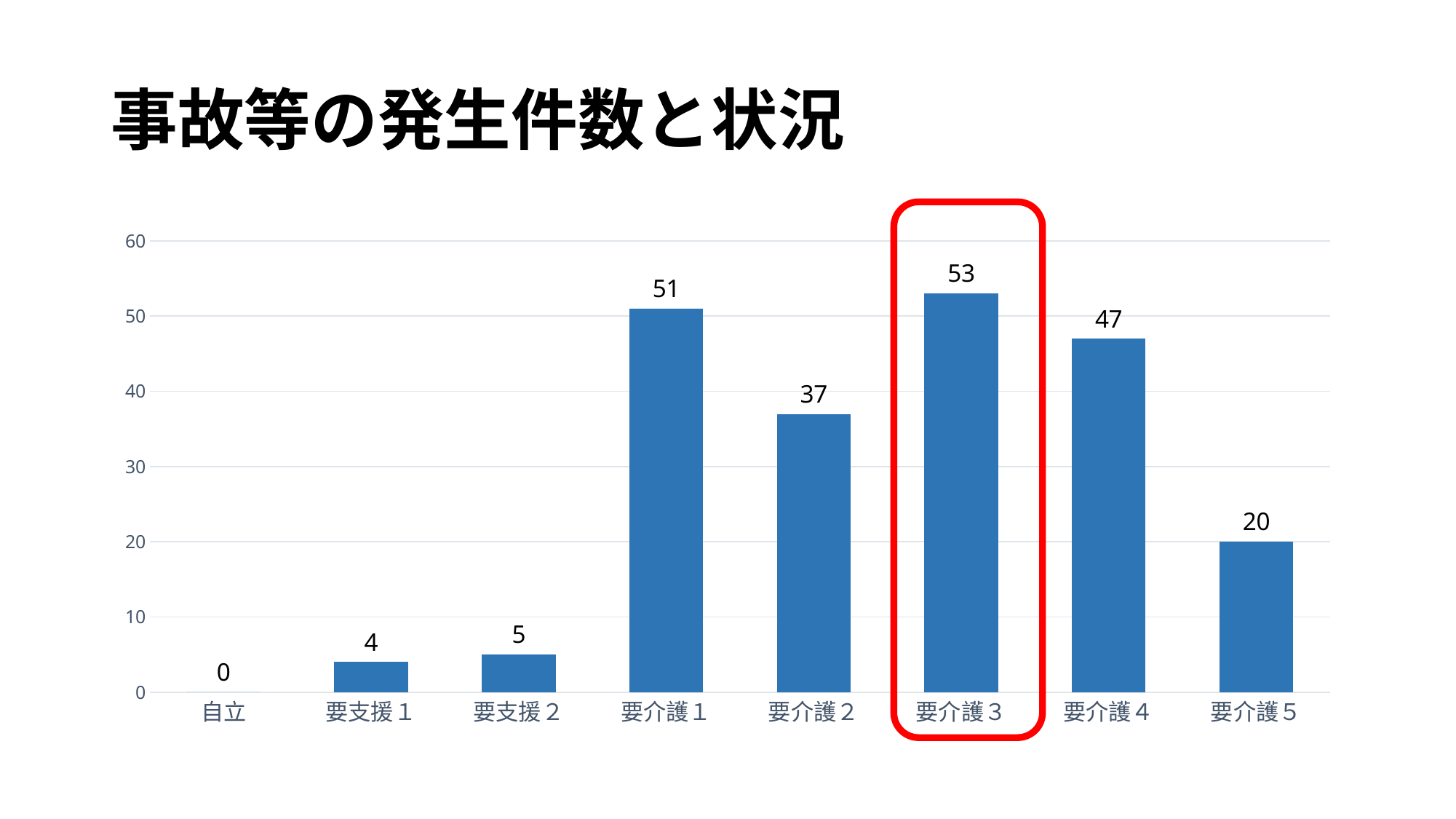
What is the difference between the values for 要介護１ and 要介護２? 14 Which category is highlighted with a red rounded outline? 要介護３ Is the value for 要介護２ greater or less than 40? less Which is larger, the value for 要介護４ or the value for 要介護５? 要介護４ Which category has the highest value? 要介護３ Which category has the lowest value? 自立 What kind of chart is shown on the slide? bar chart What is the value for 要介護５? 20 What is the value for 要介護３? 53 How many categories are shown on the x axis? 8 What is the title of the slide? 事故等の発生件数と状況 What is the value for 要支援１? 4